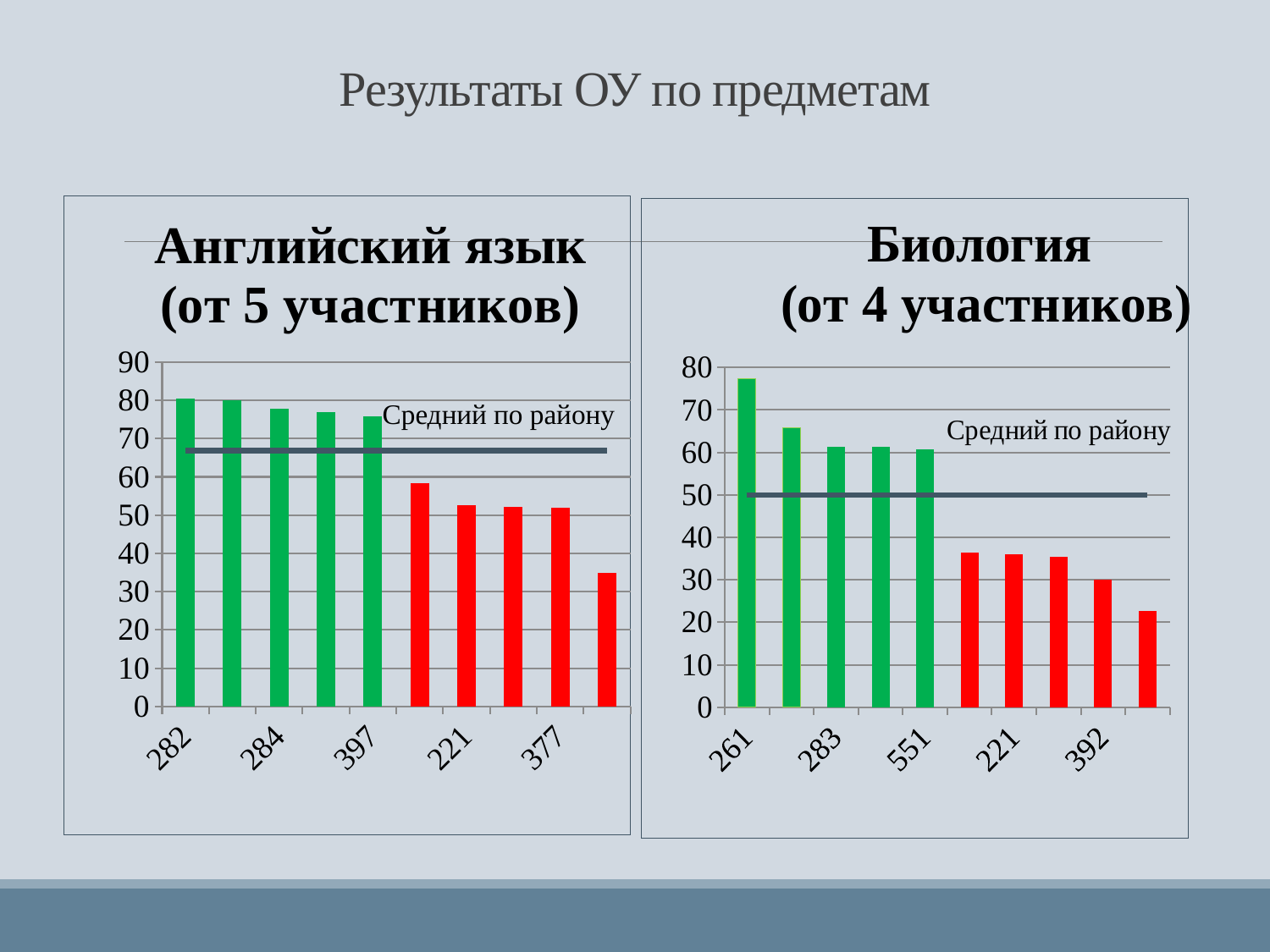
In the 'Английский язык (от 5 участников)' chart, do the bar values rise or fall from left to right? fall In the 'Английский язык (от 5 участников)' chart, is the value for 221 greater or less than 60? less In the 'Биология (от 4 участников)' chart, is the value for 221 greater or less than 40? less In the 'Английский язык (от 5 участников)' chart, is the value for 282 greater or less than 70? greater How many bars are plotted in the 'Биология (от 4 участников)' chart? 10 How many bars are plotted in the 'Английский язык (от 5 участников)' chart? 10 In the 'Биология (от 4 участников)' chart, what is the label of the horizontal line drawn across the bars? Средний по району What kind of chart is the 'Английский язык (от 5 участников)' chart? bar chart